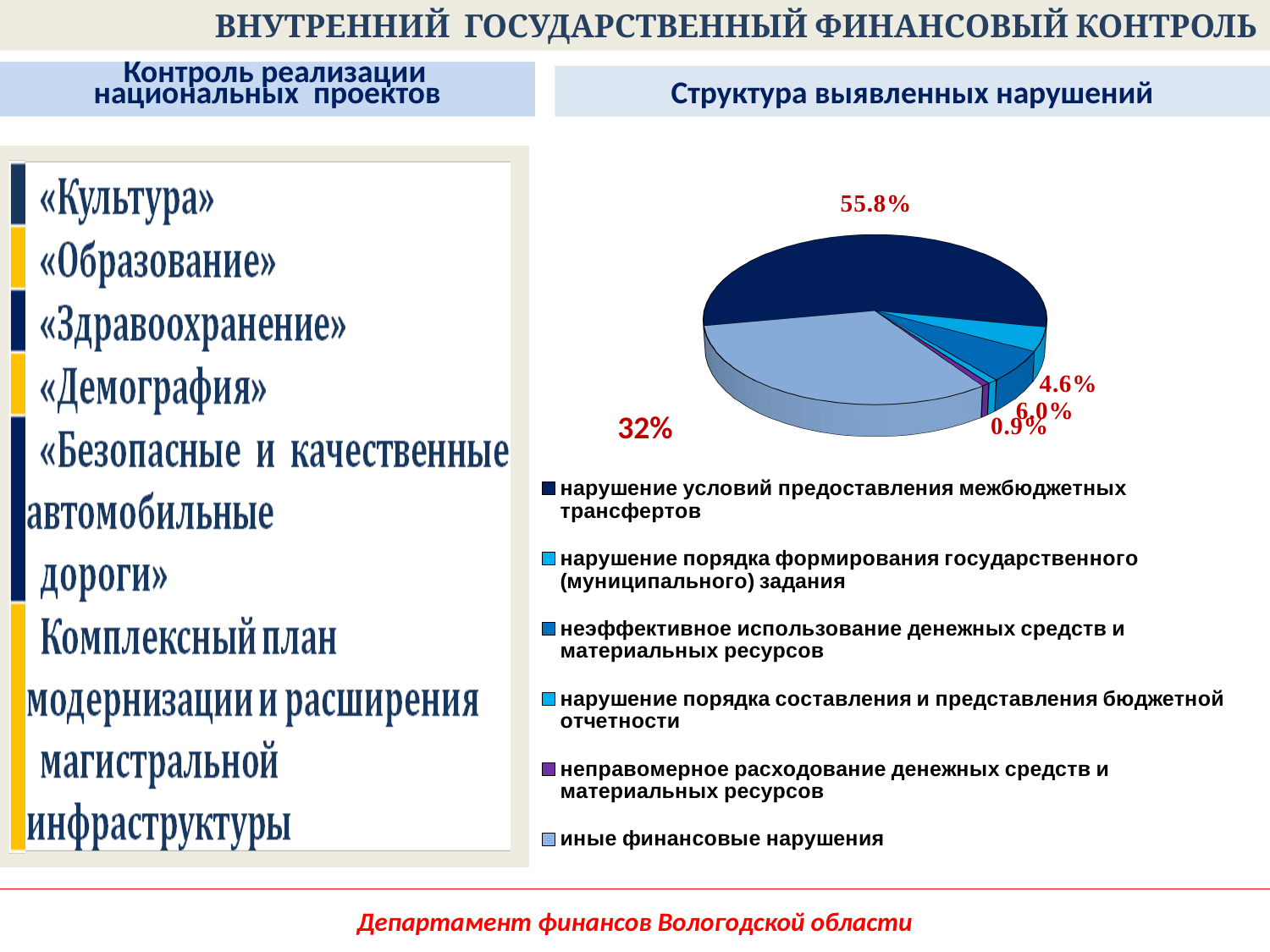
In the pie chart «Структура выявленных нарушений», what share is labelled for the largest slice? 55.8% In the pie chart «Структура выявленных нарушений», what colour is the slice for «нарушение условий предоставления межбюджетных трансфертов»? dark navy blue In the pie chart «Структура выявленных нарушений», what is the smallest percentage label shown? 0.9% What is the title of the section containing the pie chart on the right of the slide? Структура выявленных нарушений In the pie chart «Структура выявленных нарушений», which is larger: the share for «нарушение условий предоставления межбюджетных трансфертов» or the share for «иные финансовые нарушения»? нарушение условий предоставления межбюджетных трансфертов In the pie chart «Структура выявленных нарушений», which category has the largest share? нарушение условий предоставления межбюджетных трансфертов What type of chart is shown under the heading «Структура выявленных нарушений»? pie chart In the pie chart «Структура выявленных нарушений», what share is shown for «иные финансовые нарушения»? 32% How many entries does the legend of the pie chart «Структура выявленных нарушений» list? 6 In the pie chart «Структура выявленных нарушений», is the share for «нарушение условий предоставления межбюджетных трансфертов» greater or less than 50%? greater In the pie chart «Структура выявленных нарушений», what is the difference between the 55.8% slice and the 32% slice? 23.8%